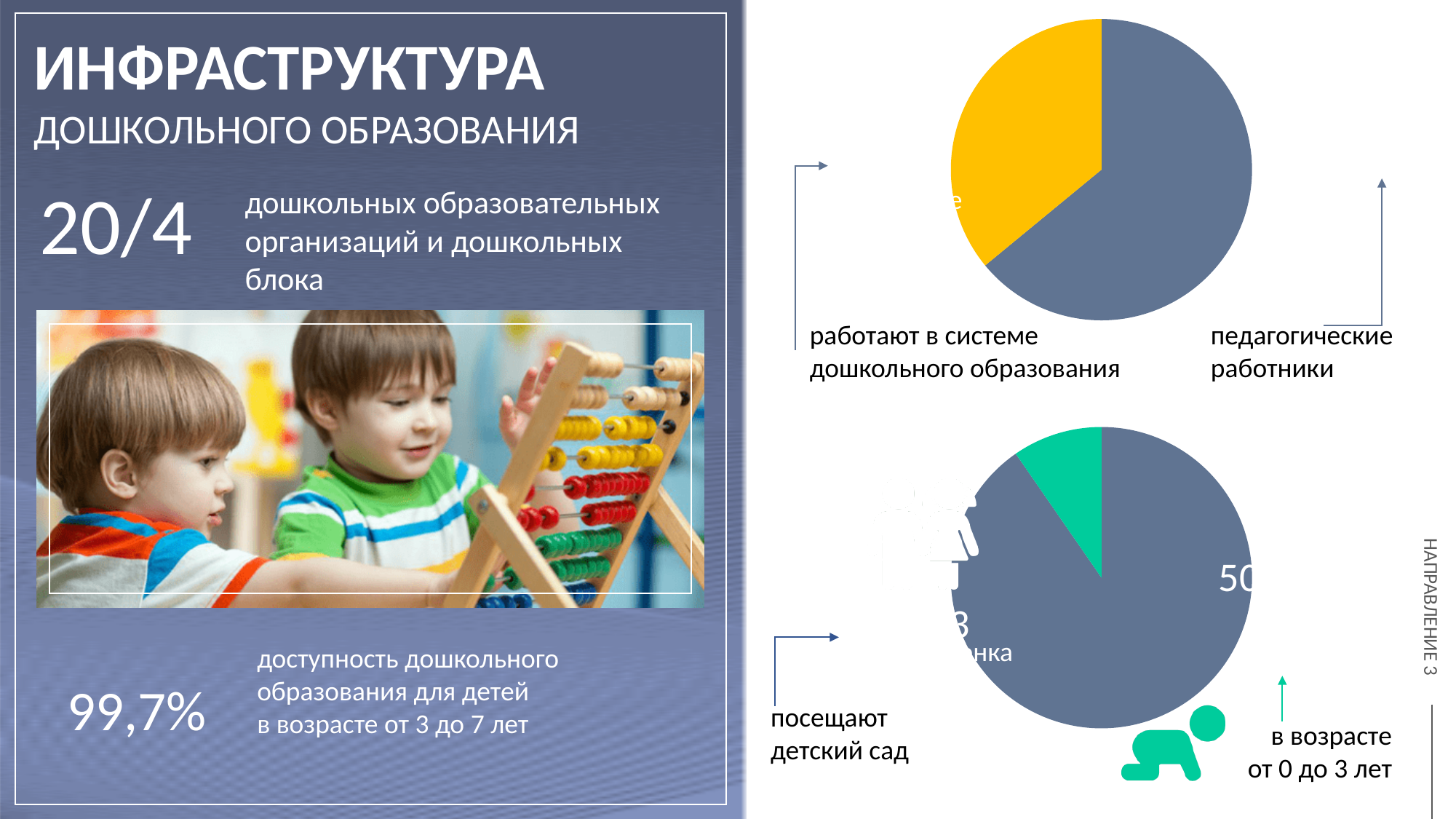
What kind of chart is the bottom chart on the right side of the slide? pie chart In the top pie chart, does the yellow slice take up more or less than half of the pie? less In the bottom pie chart, which slice is larger, the green one or the blue-gray one? the blue-gray one What colour is the smaller slice in the top pie chart? yellow How many slices does the top pie chart have? 2 How many pie charts are shown on the slide? 2 In the bottom pie chart, does the green slice take up more or less than a quarter of the pie? less In the top pie chart, which slice is larger, the yellow one or the blue-gray one? the blue-gray one In the top pie chart, what colour is the largest slice? blue-gray How many slices does the bottom pie chart have? 2 In the bottom pie chart, what colour is the smallest slice? green What kind of chart is the top chart on the right side of the slide? pie chart